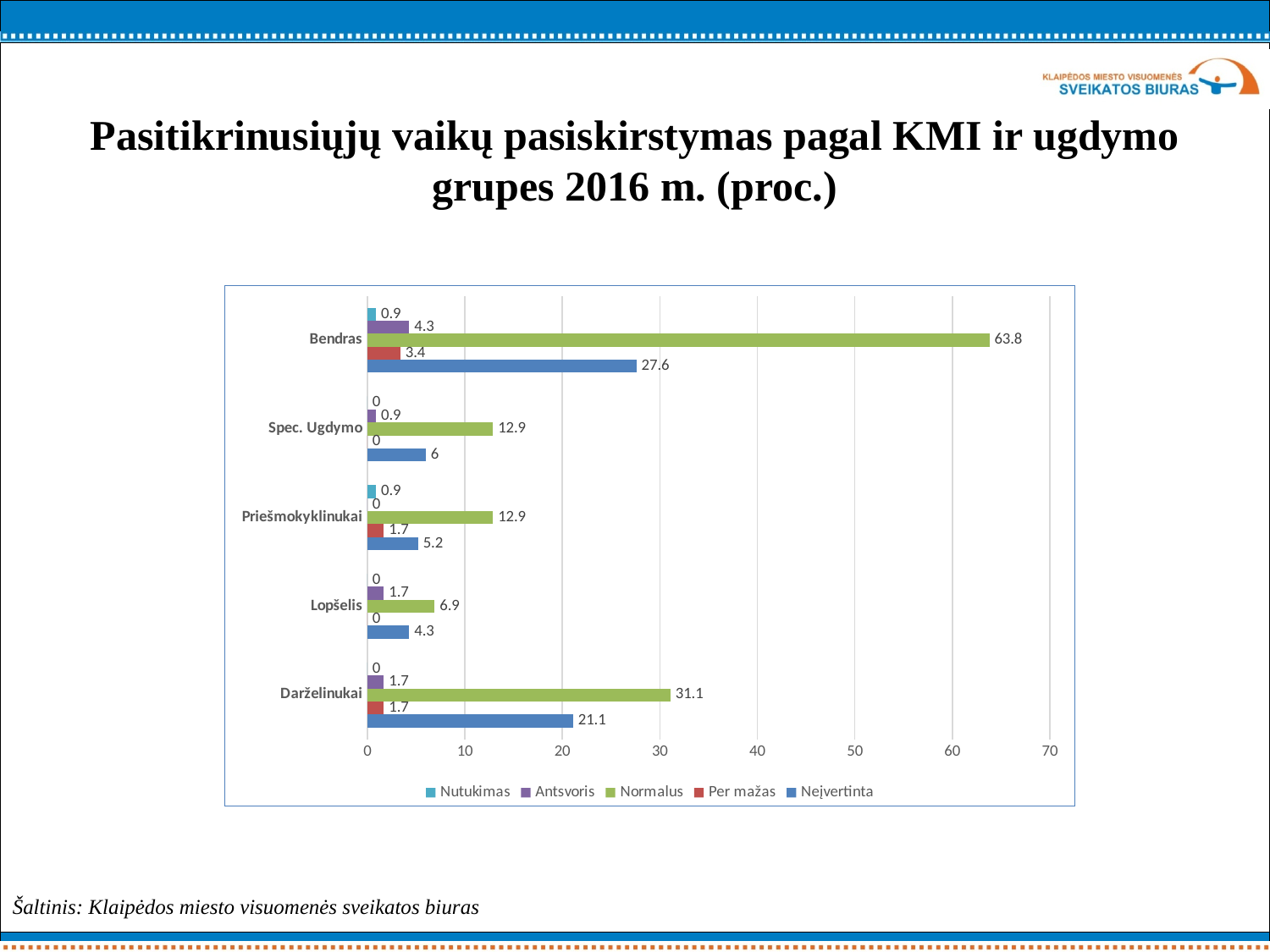
How many categories are shown on the y axis? 5 What is the Antsvoris value for Bendras? 4.3 What kind of chart is shown on the slide? Bar chart What is the Normalus value for Bendras? 63.8 What is the Per mažas value for Priešmokyklinukai? 1.7 Which is larger, the Neįvertinta value for Spec. Ugdymo or for Priešmokyklinukai? Spec. Ugdymo Which category has the lowest Neįvertinta value? Lopšelis Which category has the highest Normalus value? Bendras How many series does the legend list? 5 What is the Neįvertinta value for Darželinukai? 21.1 What is the difference between the Normalus values for Bendras and Darželinukai? 32.7 What is the Normalus value for Lopšelis? 6.9